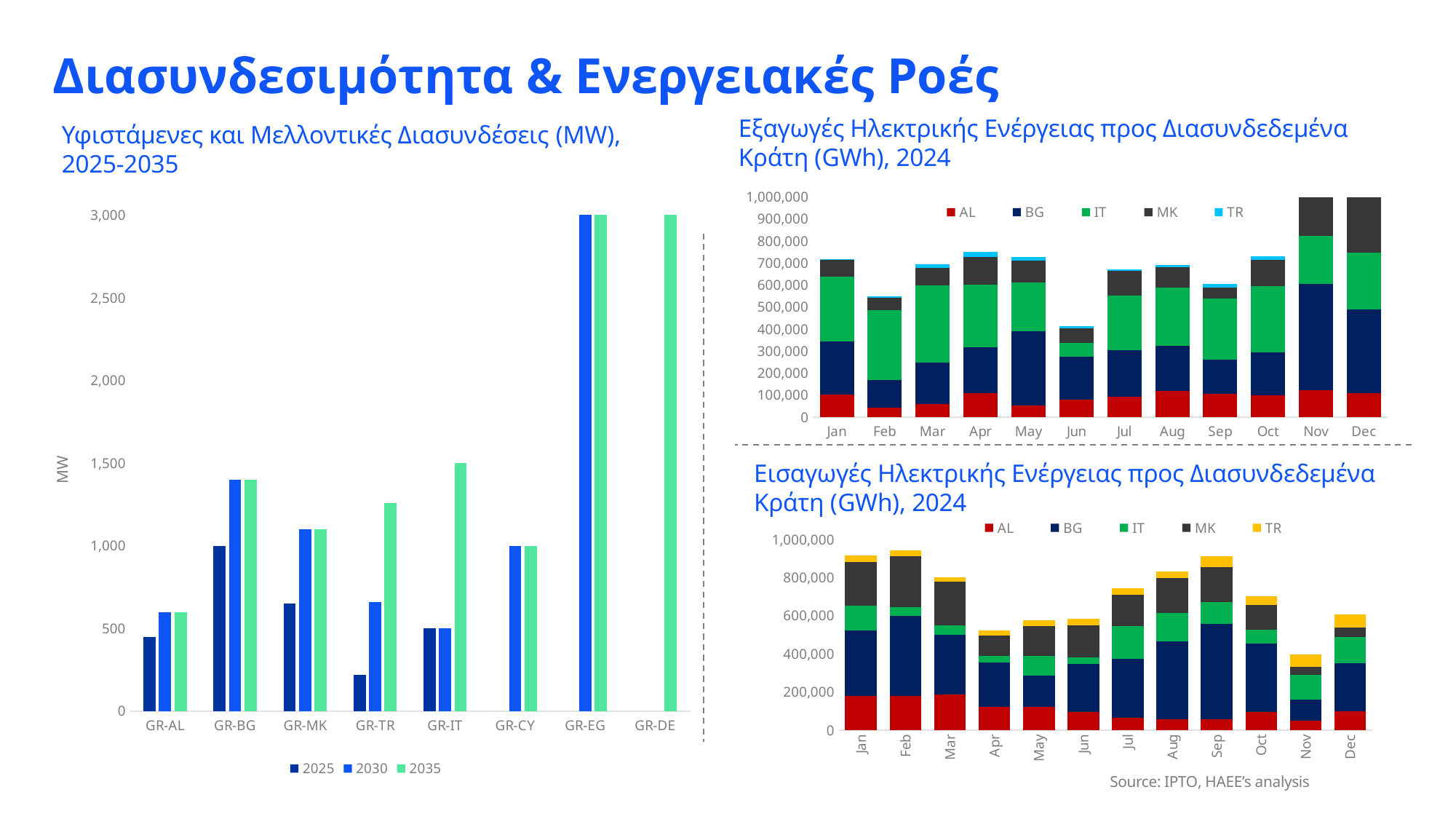
In the 'Εξαγωγές Ηλεκτρικής Ενέργειας προς Διασυνδεδεμένα Κράτη (GWh), 2024' chart, is the total for Nov greater or less than 900,000? greater In the 'Υφιστάμενες και Μελλοντικές Διασυνδέσεις (MW), 2025-2035' chart, is the 2035 value for GR-IT greater or less than 1,000? greater How many series does the legend of the 'Υφιστάμενες και Μελλοντικές Διασυνδέσεις (MW), 2025-2035' chart list? 3 How many series does the legend of the 'Εξαγωγές Ηλεκτρικής Ενέργειας προς Διασυνδεδεμένα Κράτη (GWh), 2024' chart list? 5 In the 'Εισαγωγές Ηλεκτρικής Ενέργειας προς Διασυνδεδεμένα Κράτη (GWh), 2024' chart, is the total for Apr greater or less than 600,000? less In the 'Εξαγωγές Ηλεκτρικής Ενέργειας προς Διασυνδεδεμένα Κράτη (GWh), 2024' chart, which month has the lowest total? Jun In the 'Εισαγωγές Ηλεκτρικής Ενέργειας προς Διασυνδεδεμένα Κράτη (GWh), 2024' chart, which month has the lowest total? Nov In the 'Υφιστάμενες και Μελλοντικές Διασυνδέσεις (MW), 2025-2035' chart, which category has the highest 2030 value? GR-EG How many categories are shown on the x axis of the 'Υφιστάμενες και Μελλοντικές Διασυνδέσεις (MW), 2025-2035' chart? 8 What kind of chart is the 'Υφιστάμενες και Μελλοντικές Διασυνδέσεις (MW), 2025-2035' chart on the left? Bar chart In the 'Υφιστάμενες και Μελλοντικές Διασυνδέσεις (MW), 2025-2035' chart, which is larger: the 2035 value for GR-BG or the 2035 value for GR-MK? GR-BG